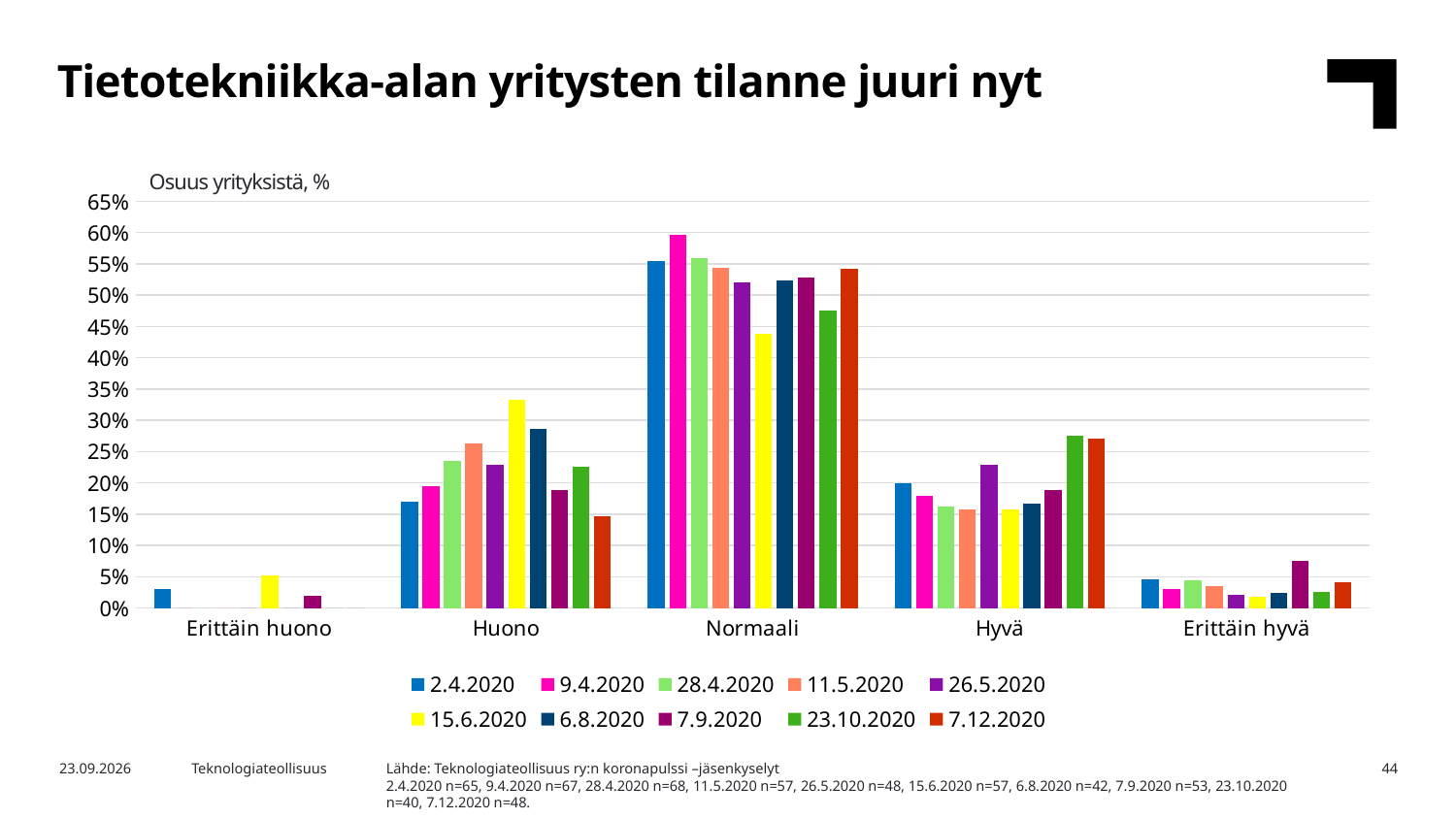
In the Hyvä category, which is larger: the value for 23.10.2020 or the value for 2.4.2020? 23.10.2020 What kind of chart is shown on the slide? bar chart In the Erittäin hyvä category, which survey date has the highest value? 7.9.2020 In the Normaali category, which survey date has the lowest value? 15.6.2020 Is the value for 15.6.2020 in the Huono category greater or less than 30%? greater In the Normaali category, which survey date has the highest value? 9.4.2020 What is the label shown above the vertical axis of the chart? Osuus yrityksistä, % How many series does the legend list? 10 How many categories are shown on the x axis of the chart? 5 Is the value for 9.4.2020 in the Normaali category greater or less than 55%? greater Is the value for 15.6.2020 in the Normaali category greater or less than 50%? less In the Huono category, which survey date has the highest value? 15.6.2020